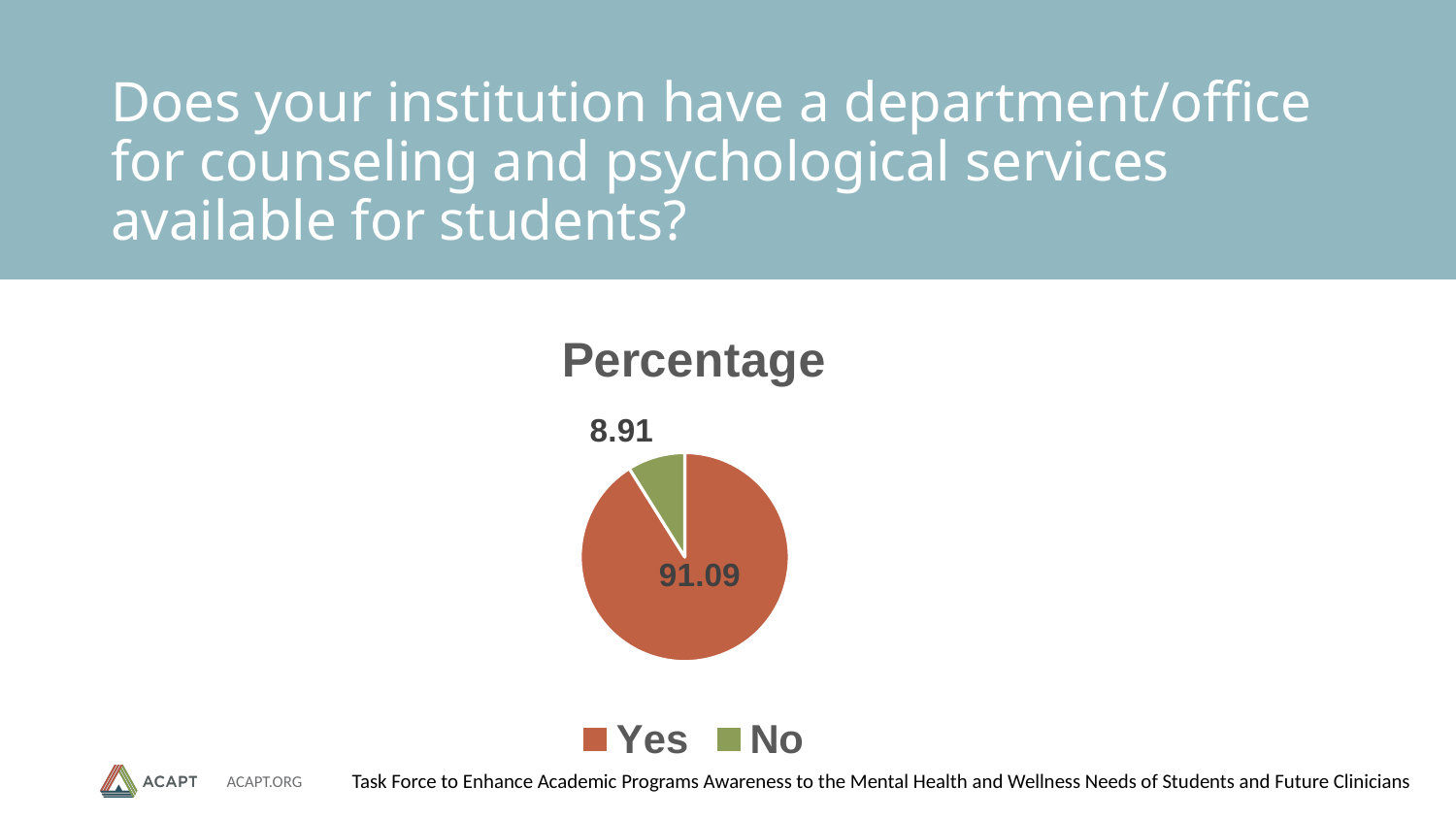
What is the value for Yes? 91.09 How many entries does the legend list? 2 Which category has the largest slice? Yes Which is larger, the value for Yes or the value for No? Yes What is the title of the chart? Percentage Which category has the smallest slice? No What is the value for No? 8.91 What kind of chart is shown on the slide? pie chart What colour is the Yes slice? orange-red What is the difference between the Yes and No values? 82.18 How many slices does the pie chart have? 2